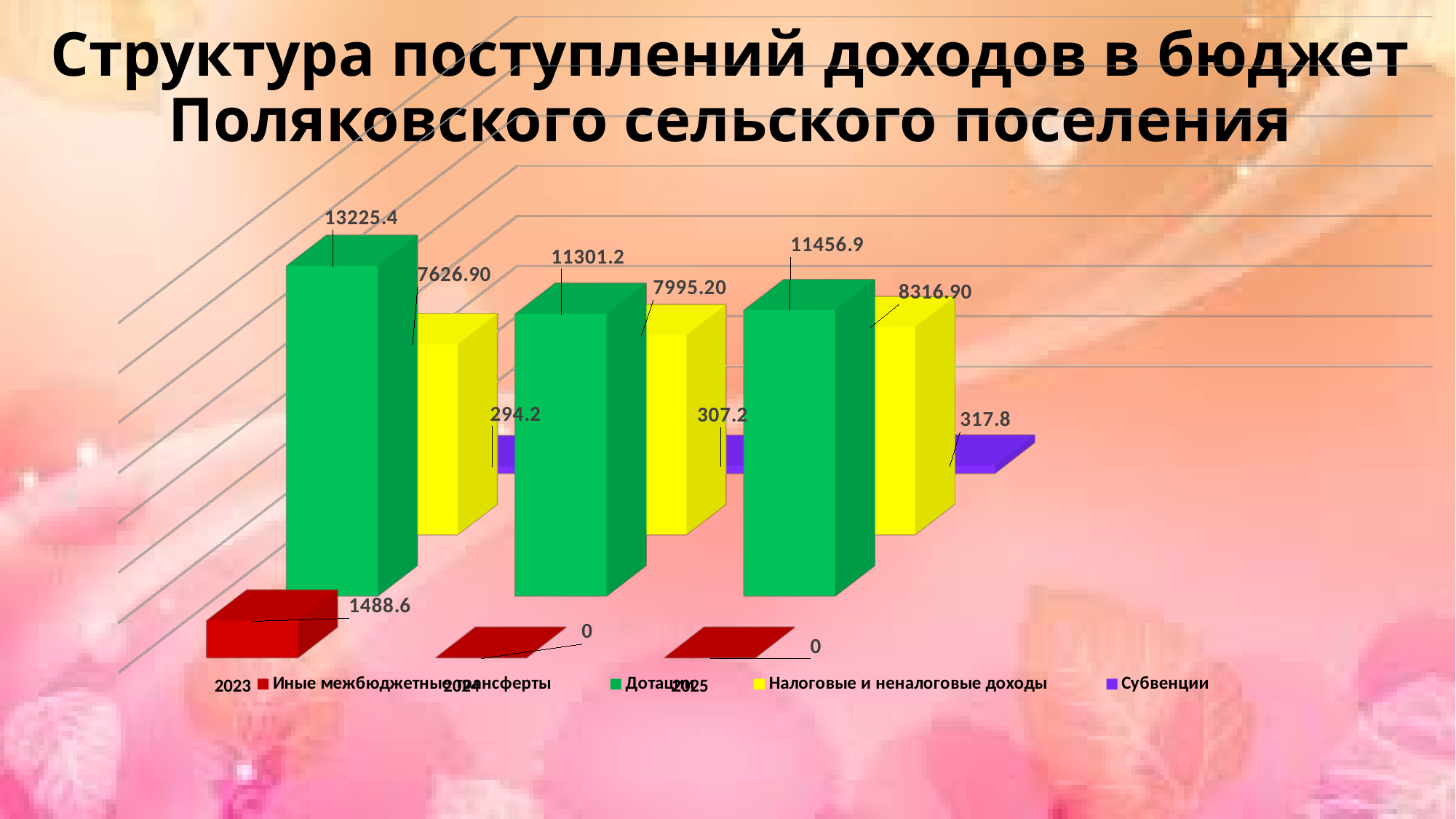
What is the value of Иные межбюджетные трансферты for 2023? 1488.6 What is the value of Налоговые и неналоговые доходы for 2025? 8316.90 Which is larger: Дотации for 2025 or Дотации for 2024? Дотации for 2025 How many series does the legend list? 4 Do the values of Субвенции rise or fall from 2023 to 2025? rise What is the value of Дотации for 2023? 13225.4 In which year is the value of Дотации the highest? 2023 What is the value of Субвенции for 2024? 307.2 What is the difference between the Дотации values for 2023 and 2024? 1924.2 In which year is the value of Налоговые и неналоговые доходы the lowest? 2023 What type of chart is shown on the slide? bar chart How many year categories are shown on the x axis? 3